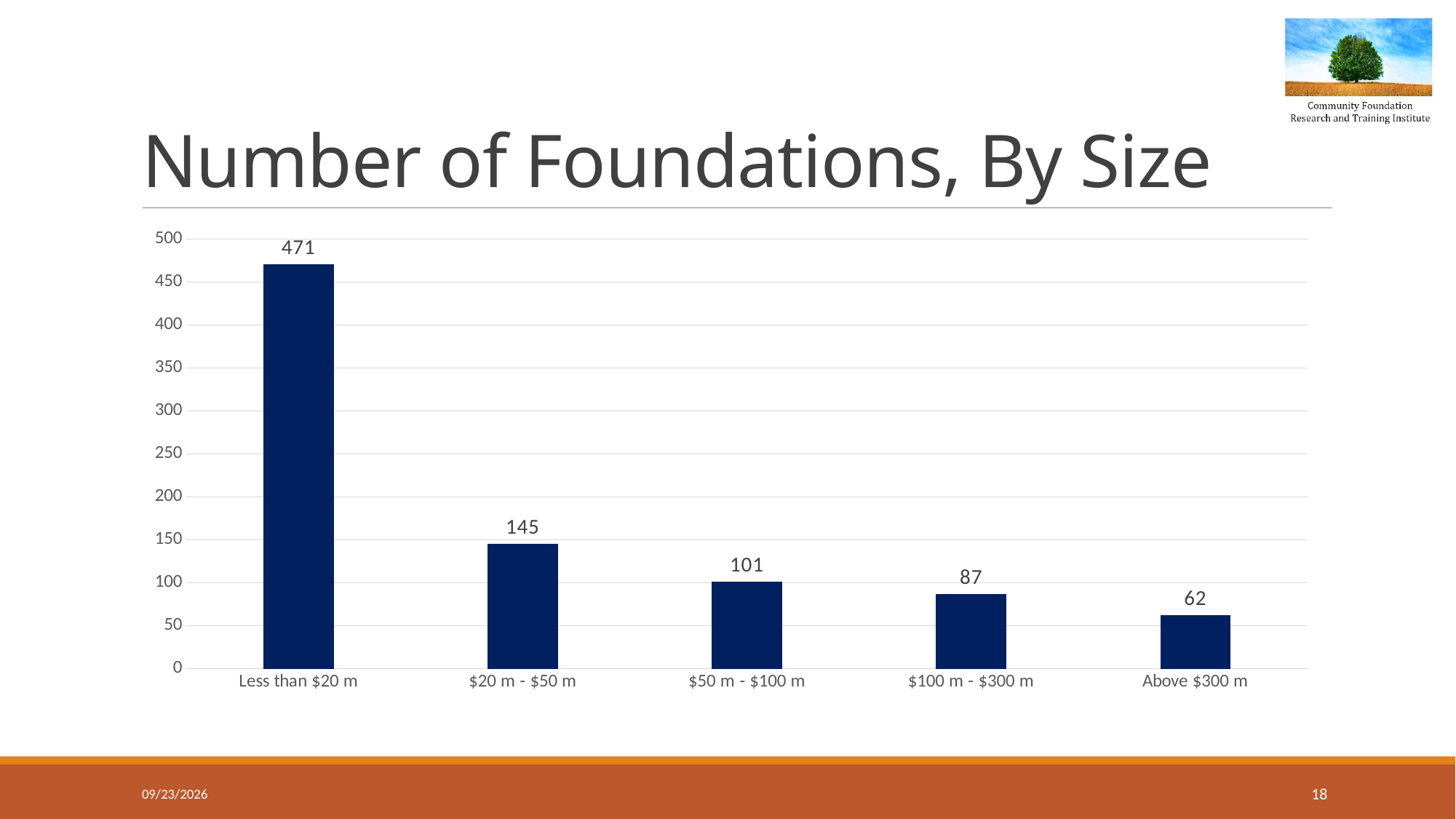
What is the number of foundations in the 'Above $300 m' category? 62 What kind of chart is shown on the slide? Bar chart Which size category has the lowest number of foundations? Above $300 m Which category has more foundations: '$50 m - $100 m' or '$100 m - $300 m'? $50 m - $100 m Do the values rise or fall moving from left to right along the x axis? Fall What is the number of foundations in the 'Less than $20 m' category? 471 What is the number of foundations in the '$100 m - $300 m' category? 87 What is the number of foundations in the '$20 m - $50 m' category? 145 What is the difference between the number of foundations in the 'Less than $20 m' and '$20 m - $50 m' categories? 326 How many size categories are shown on the chart? 5 Is the value for '$50 m - $100 m' greater or less than 100? greater Which size category has the highest number of foundations? Less than $20 m